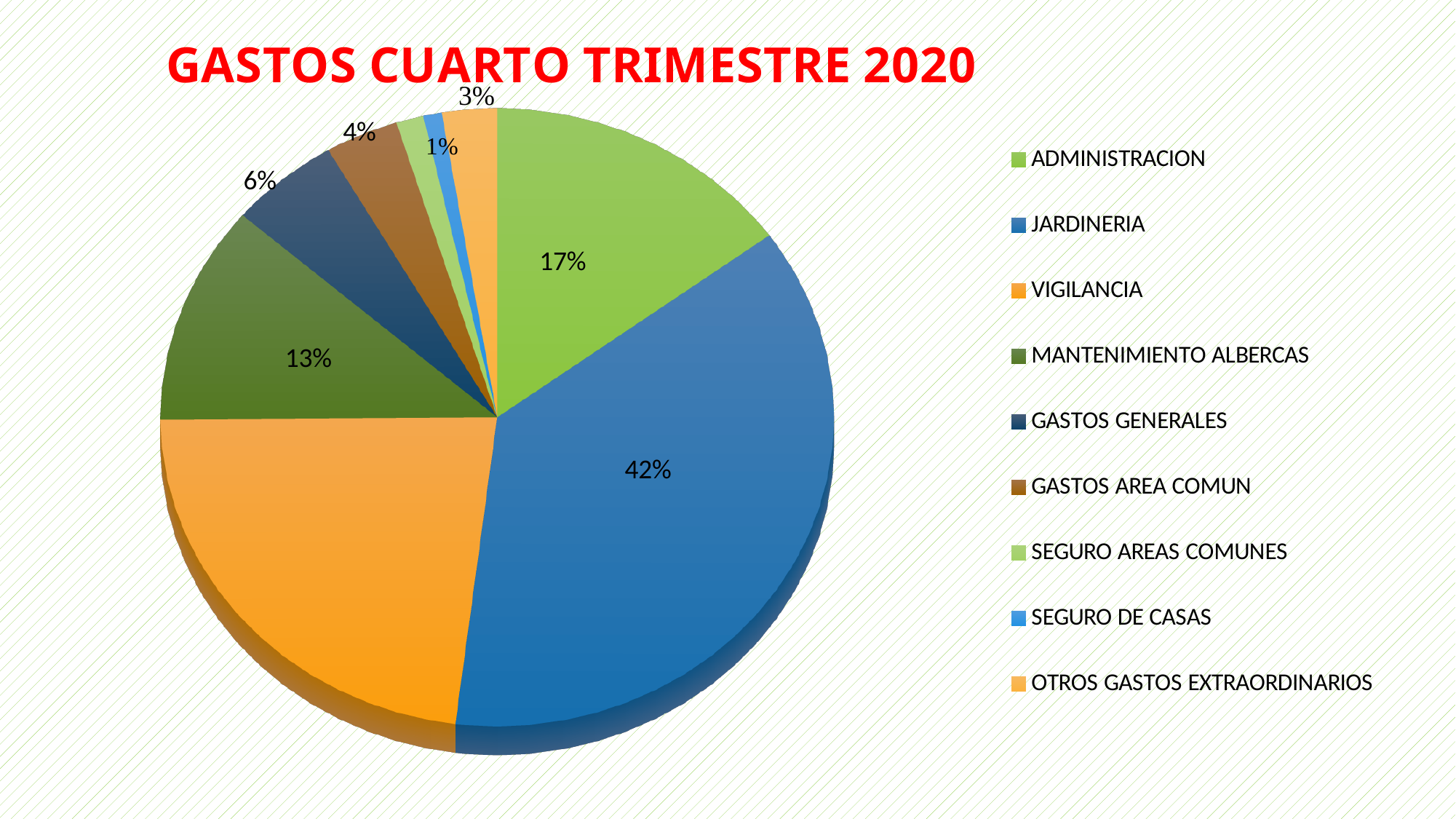
How many percentage points larger is the JARDINERIA slice than the ADMINISTRACION slice? 25 How many categories does the legend list? 9 What percentage of the pie does JARDINERIA represent? 42% What is the title of the chart? GASTOS CUARTO TRIMESTRE 2020 What percentage of the pie does GASTOS GENERALES represent? 6% Which slice is larger, ADMINISTRACION or MANTENIMIENTO ALBERCAS? ADMINISTRACION What percentage of the pie does MANTENIMIENTO ALBERCAS represent? 13% What percentage of the pie does ADMINISTRACION represent? 17% Which category has the largest slice of the pie? JARDINERIA What kind of chart is shown on the slide? pie chart What percentage of the pie does GASTOS AREA COMUN represent? 4% What percentage of the pie does OTROS GASTOS EXTRAORDINARIOS represent? 3%